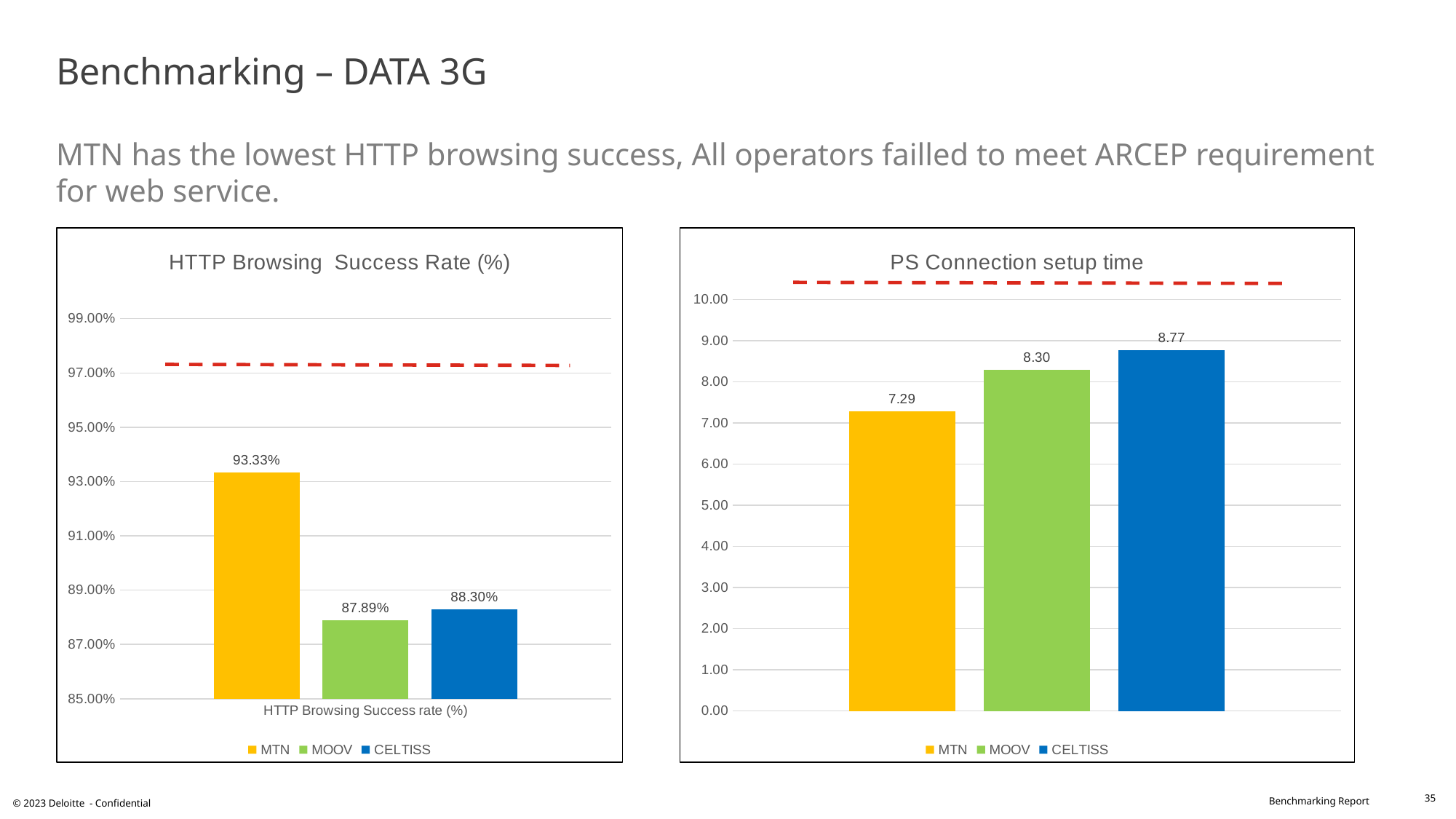
In the HTTP Browsing Success Rate (%) chart, which operator has the highest success rate? MTN In the PS Connection setup time chart, is the value for MOOV greater or less than 8.00? greater In the HTTP Browsing Success Rate (%) chart, which operator has the lowest success rate? MOOV In the PS Connection setup time chart, what is the value for MTN? 7.29 In the HTTP Browsing Success Rate (%) chart, what is the value for MOOV? 87.89% In the PS Connection setup time chart, what is the difference between the MOOV and MTN values? 1.01 In the HTTP Browsing Success Rate (%) chart, what is the value for MTN? 93.33% In the HTTP Browsing Success Rate (%) chart, how many series does the legend list? 3 In the HTTP Browsing Success Rate (%) chart, what is the difference between the MTN and CELTISS values? 5.03% What kind of chart is the PS Connection setup time chart? Bar chart In the PS Connection setup time chart, what is the value for CELTISS? 8.77 In the PS Connection setup time chart, which operator has the highest setup time? CELTISS